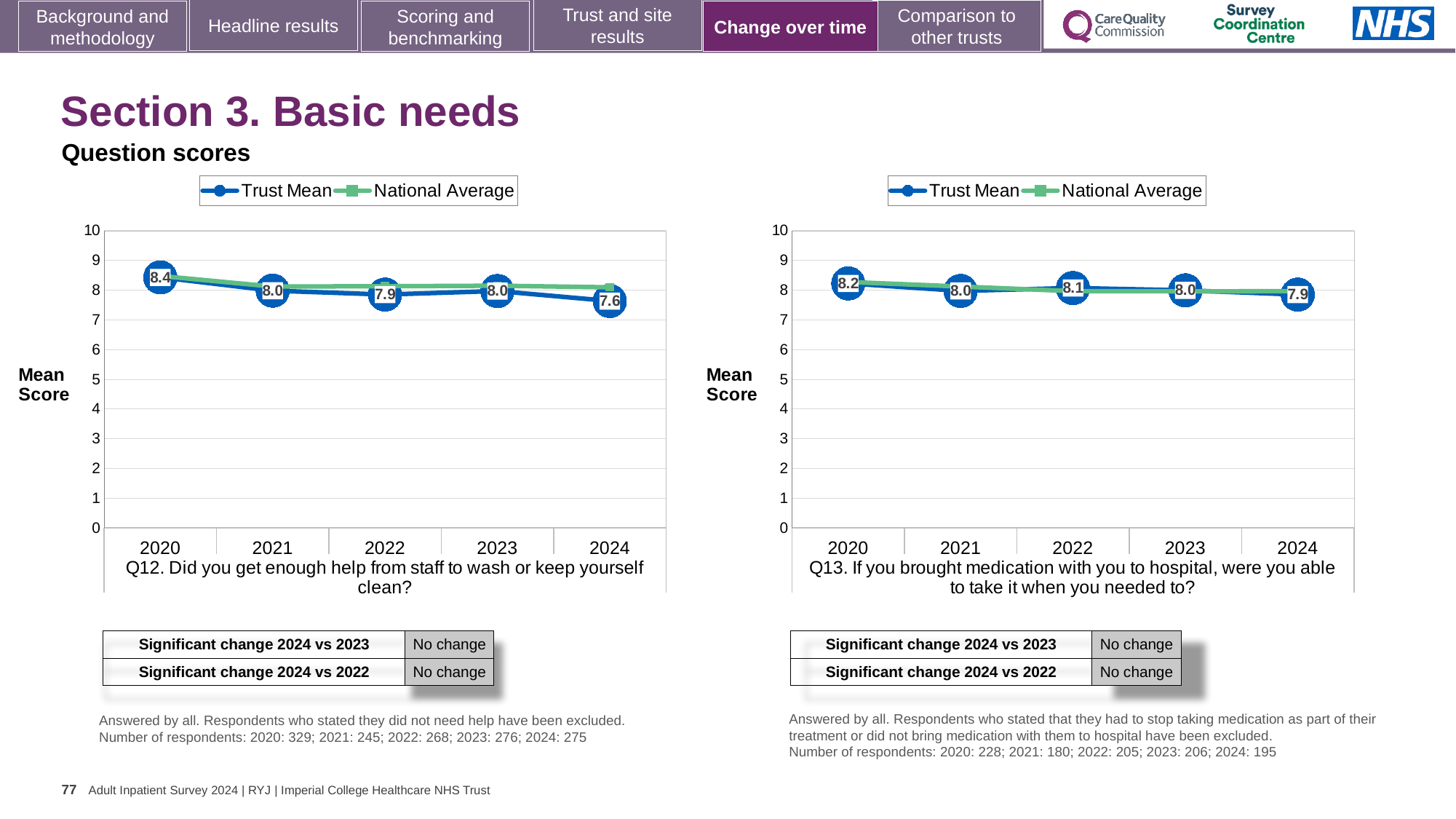
What type of chart is used for Q12 (left)? Line chart On the Q12 chart (left), what is the difference between the Trust Mean scores for 2020 and 2024? 0.8 On the Q12 chart (left), what is the Trust Mean score for 2020? 8.4 On the Q13 chart (right), is the Trust Mean score for 2020 or 2024 larger? 2020 On the Q13 chart (right), which year has the highest Trust Mean score? 2020 On the Q12 chart (left), which year has the highest Trust Mean score? 2020 On the Q12 chart (left), what is the Trust Mean score for 2024? 7.6 On the Q12 chart (left), which year has the lowest Trust Mean score? 2024 On the Q13 chart (right), what is the Trust Mean score for 2024? 7.9 On the Q13 chart (right), what is the Trust Mean score for 2022? 8.1 How many series does the legend of the Q12 chart (left) list? 2 How many years are plotted on the Q13 chart (right)? 5